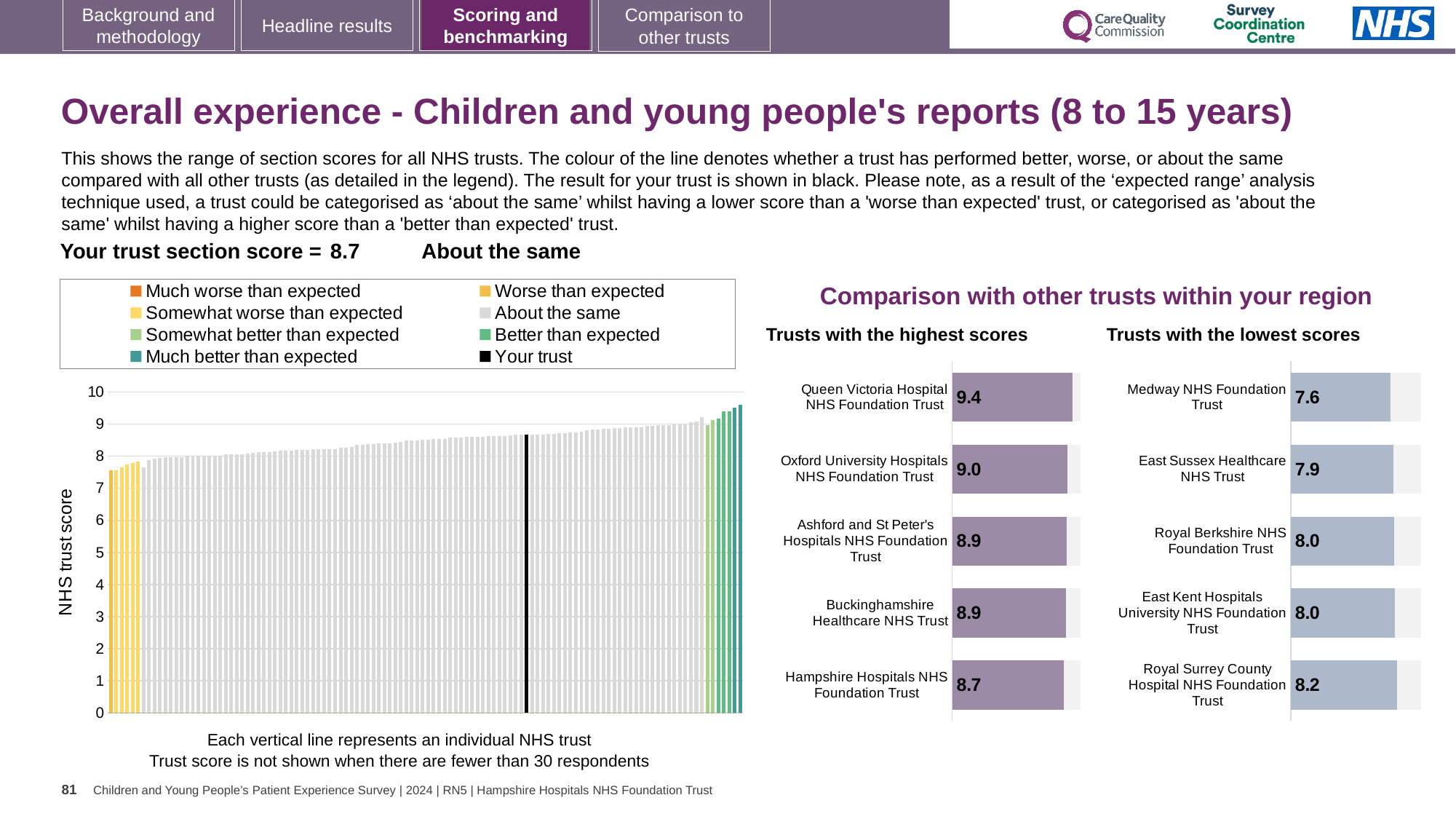
In the 'Trusts with the lowest scores' chart, what is the score for Medway NHS Foundation Trust? 7.6 What kind of chart is the large 'NHS trust score' chart on the left? Bar chart Which has the larger score: Oxford University Hospitals NHS Foundation Trust in the highest scores chart or Royal Surrey County Hospital NHS Foundation Trust in the lowest scores chart? Oxford University Hospitals NHS Foundation Trust In the 'Trusts with the highest scores' chart, which trust has the highest score? Queen Victoria Hospital NHS Foundation Trust In the large 'NHS trust score' chart, is the value for your trust (the black line) greater or less than 8? greater In the 'Trusts with the highest scores' chart, what is the difference between the scores of Queen Victoria Hospital NHS Foundation Trust and Hampshire Hospitals NHS Foundation Trust? 0.7 In the large 'NHS trust score' chart, what is the section score for your trust (the black line)? 8.7 In the 'Trusts with the lowest scores' chart, which trust has the lowest score? Medway NHS Foundation Trust In the 'Trusts with the lowest scores' chart, what is the difference between the scores of Royal Surrey County Hospital NHS Foundation Trust and Medway NHS Foundation Trust? 0.6 How many trusts are shown in the 'Trusts with the highest scores' chart? 5 How many entries does the legend above the large 'NHS trust score' chart list? 8 In the 'Trusts with the highest scores' chart, what is the score for Queen Victoria Hospital NHS Foundation Trust? 9.4